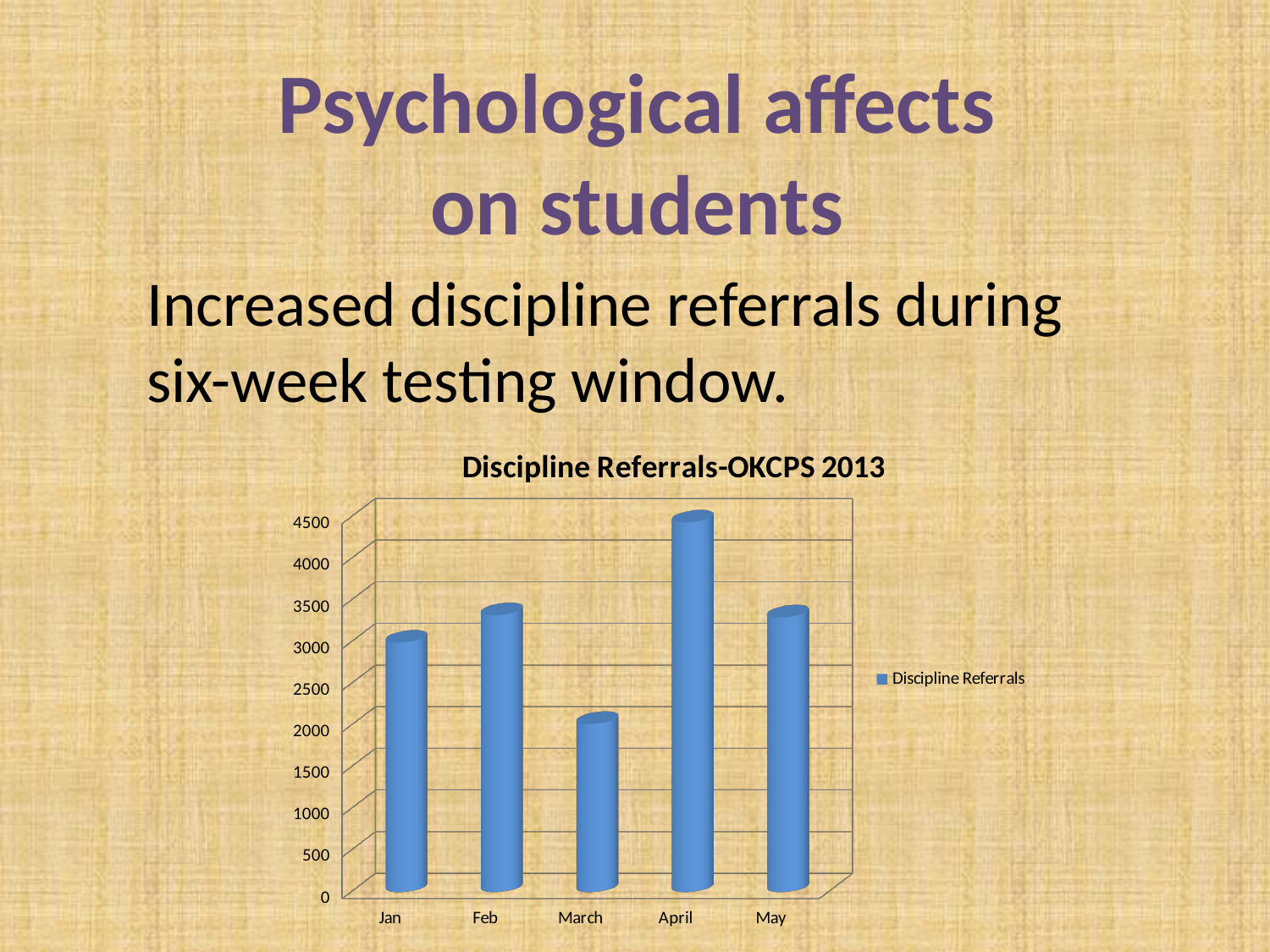
Is the value for March greater or less than 2500? less Is the value for Jan greater or less than 2500? greater Which month has the highest number of discipline referrals? April Which month has the lowest number of discipline referrals? March What is the title of the chart? Discipline Referrals-OKCPS 2013 Which month has more discipline referrals, Jan or April? April What kind of chart is shown on the slide? bar chart How many series does the chart's legend list? 1 How many months are shown on the x axis of the chart? 5 Which month has more discipline referrals, March or Feb? Feb What is the name of the series listed in the legend? Discipline Referrals Is the value for April greater or less than 4000? greater